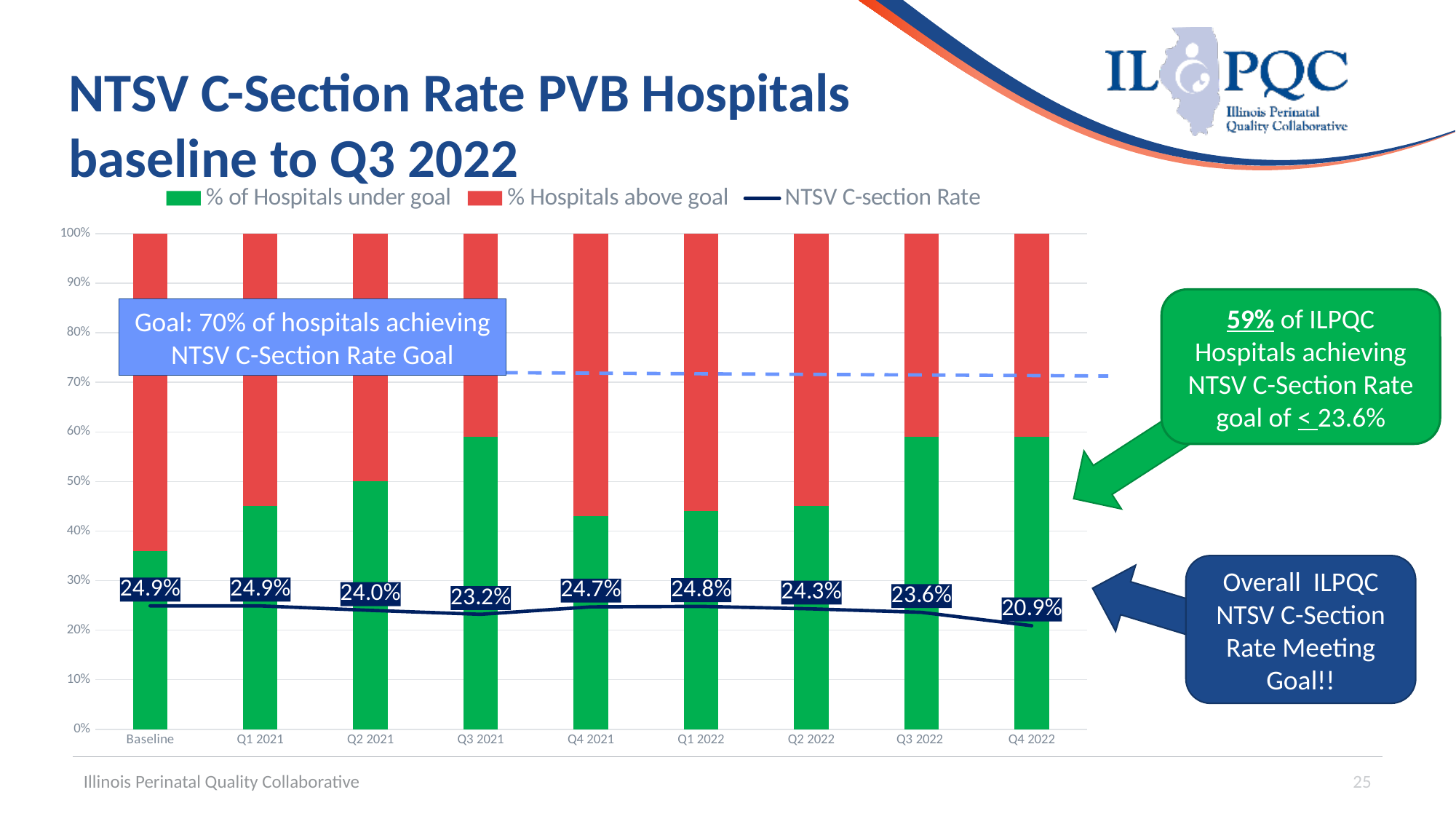
What is the difference between the NTSV C-section Rate at Baseline and in Q4 2022? 4.0 percentage points Is the % of Hospitals under goal (green bar) at Baseline greater or less than 40%? less How many time periods are shown on the x axis? 9 Which period has the lowest NTSV C-section Rate on the line? Q4 2022 How many series does the legend list? 3 What is the NTSV C-section Rate shown at Baseline? 24.9% Is the % of Hospitals under goal (green bar) for Q3 2021 greater or less than 50%? greater Which is higher, the NTSV C-section Rate in Q2 2021 or in Q1 2022? Q1 2022 What is the NTSV C-section Rate shown for Q3 2021? 23.2% What is the NTSV C-section Rate shown for Q4 2022? 20.9% What kind of chart is shown on the slide? A stacked bar chart with a line Does the NTSV C-section Rate line overall rise or fall from Baseline to Q4 2022? Fall